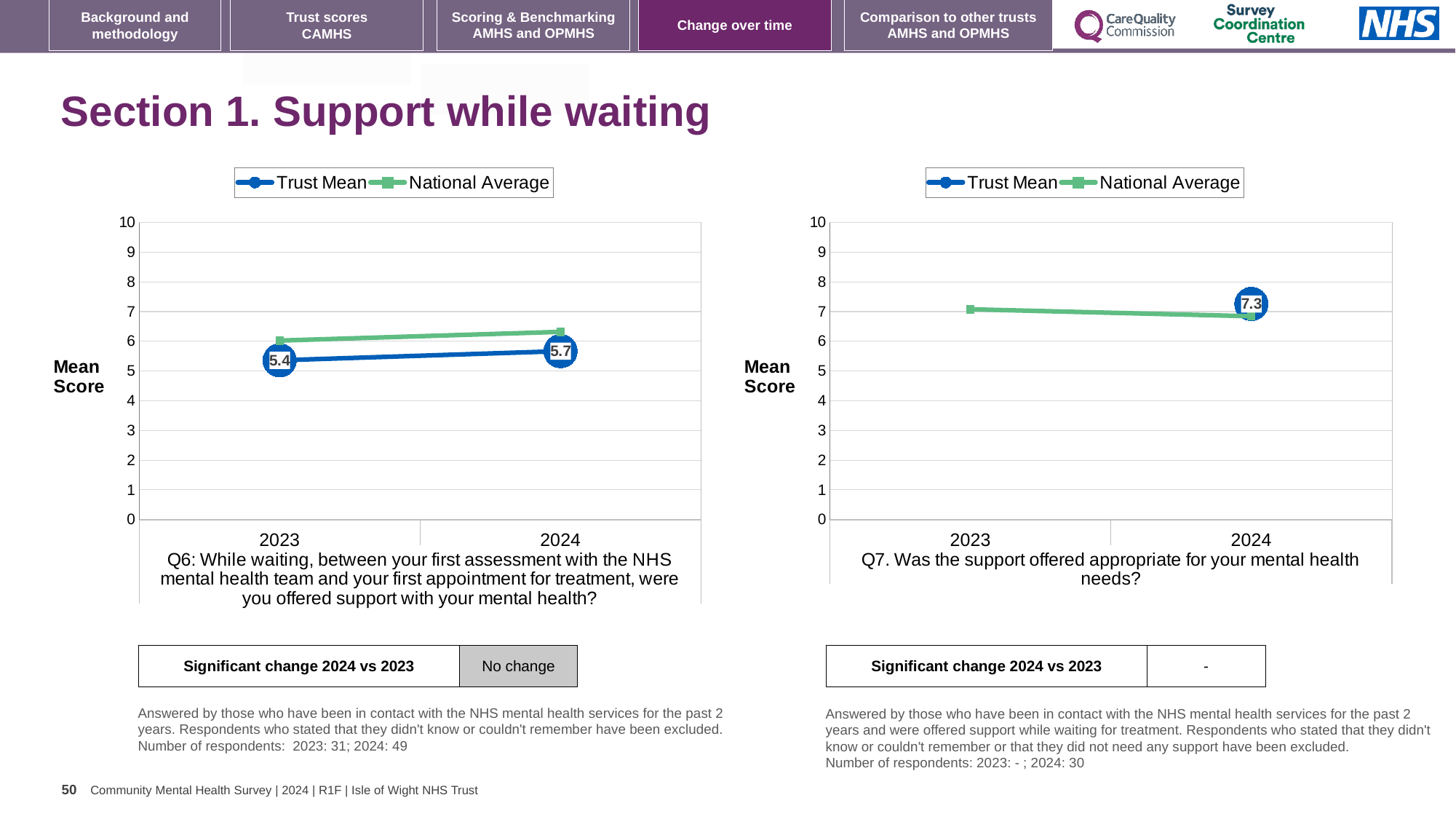
On the left chart (Q6), what is the Trust Mean score for 2024? 5.7 What type of chart is the right chart (Q7)? line chart On the left chart (Q6), what is the Trust Mean score for 2023? 5.4 How many series does the legend of the left chart (Q6) list? 2 On the right chart (Q7), is the National Average for 2023 greater or less than 8? less On the left chart (Q6), does the Trust Mean rise or fall from 2023 to 2024? rise On the left chart (Q6), which is higher in 2024, the Trust Mean or the National Average? National Average On the left chart (Q6), is the National Average for 2023 greater or less than 5? greater On the right chart (Q7), which is higher in 2024, the Trust Mean or the National Average? Trust Mean On the right chart (Q7), does the National Average rise or fall from 2023 to 2024? fall On the right chart (Q7), what is the Trust Mean score for 2024? 7.3 On the left chart (Q6), by how much did the Trust Mean change from 2023 to 2024? 0.3